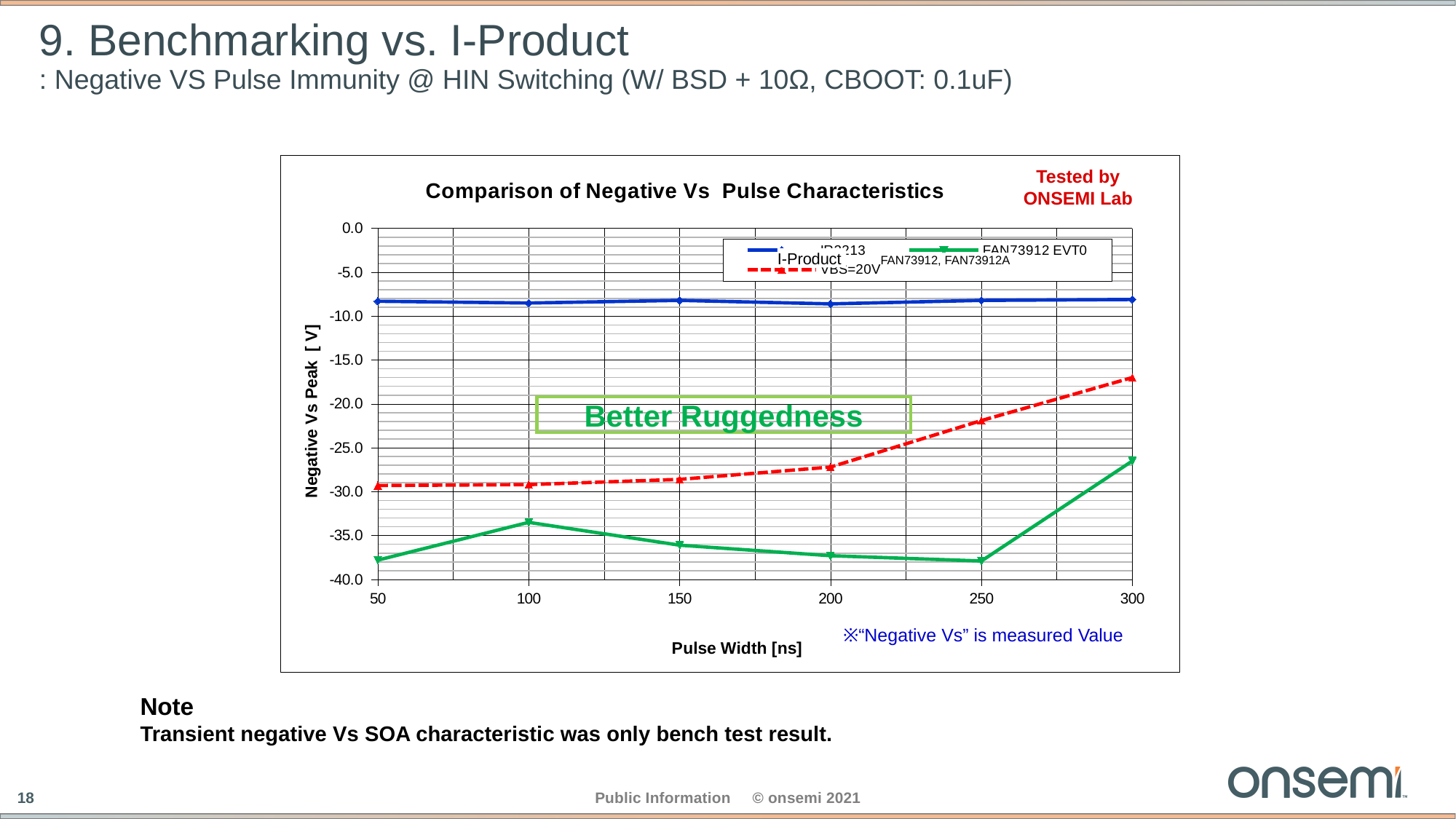
Is the value for FAN73912 EVT0 at 50 ns greater or less than -35.0? less What kind of chart is shown on the slide? line chart Which series has the highest values across the whole chart? I-Product Which series has the lowest value at 250 ns? FAN73912 EVT0 How many pulse width points are plotted along the x axis of the chart? 6 Is the value for I-Product at 300 ns greater or less than -10.0? greater Is the value of the red dashed series at 50 ns greater or less than -25.0? less What is the label of the x axis of the chart? Pulse Width [ns] How many series does the chart's legend list? 3 Do the values of the red dashed series rise or fall from 200 ns to 300 ns? rise At 300 ns, which series has the higher value, I-Product or FAN73912 EVT0? I-Product